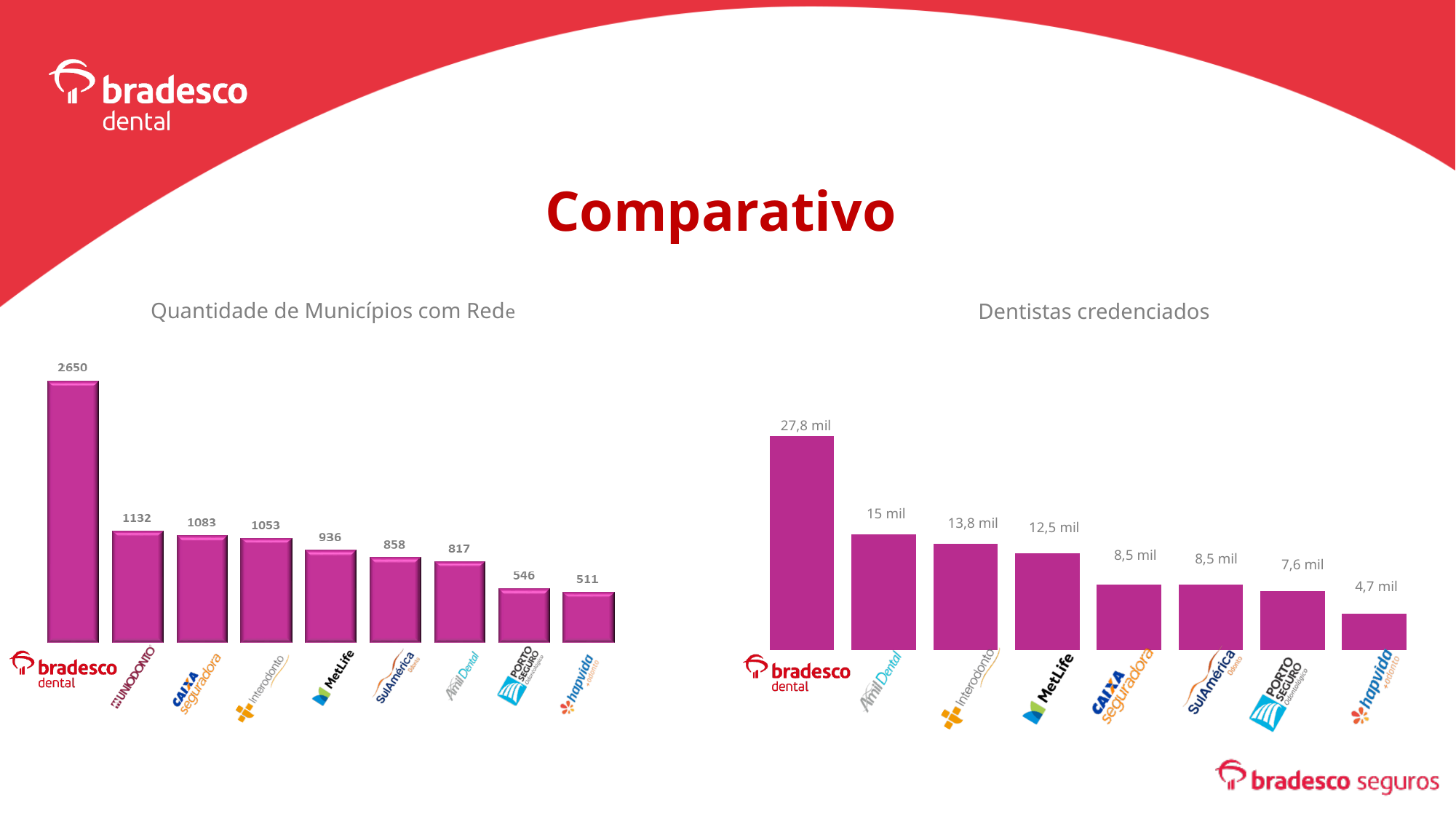
In the 'Dentistas credenciados' chart, what is the value for Hapvida? 4,7 mil In the 'Quantidade de Municípios com Rede' chart, how many companies are shown? 9 In the 'Quantidade de Municípios com Rede' chart, what is the value for MetLife? 936 In the 'Dentistas credenciados' chart, which is larger, Interodonto or MetLife? Interodonto In the 'Quantidade de Municípios com Rede' chart, which company has the lowest value? Hapvida In the 'Quantidade de Municípios com Rede' chart, what is the value for Bradesco Dental? 2650 In the 'Dentistas credenciados' chart, what is the value for Amil Dental? 15 mil In the 'Quantidade de Municípios com Rede' chart, what is the difference between Uniodonto and Porto Seguro? 586 What type of chart is the 'Dentistas credenciados' chart? Bar chart In the 'Dentistas credenciados' chart, which company has the highest value? Bradesco Dental In the 'Quantidade de Municípios com Rede' chart, do the values rise or fall from left to right? Fall In the 'Dentistas credenciados' chart, how many companies are shown? 8